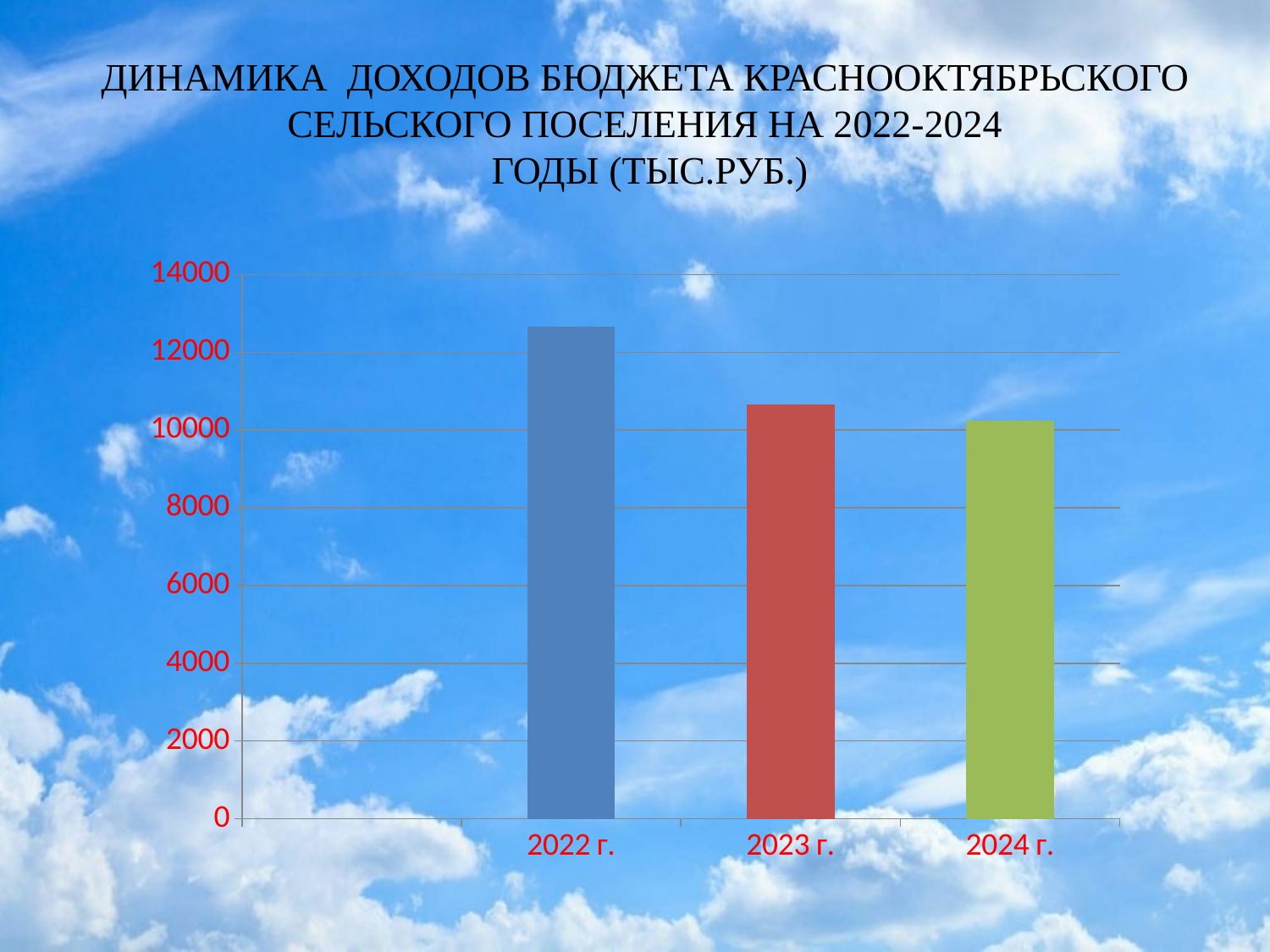
Is the value for 2023 г. greater or less than 12000? less Do the values rise or fall from 2022 г. to 2024 г.? fall Is the value for 2022 г. greater or less than 14000? less Which year has the lowest budget income on the chart? 2024 г. Which year has the highest budget income on the chart? 2022 г. How many years (categories) are plotted on the chart? 3 What kind of chart is shown on the slide? bar chart What unit of measurement is stated in the chart title? тыс.руб. Is the value for 2024 г. greater or less than 12000? less Which is larger, the value for 2022 г. or the value for 2023 г.? 2022 г. What colour is the bar for 2022 г.? blue